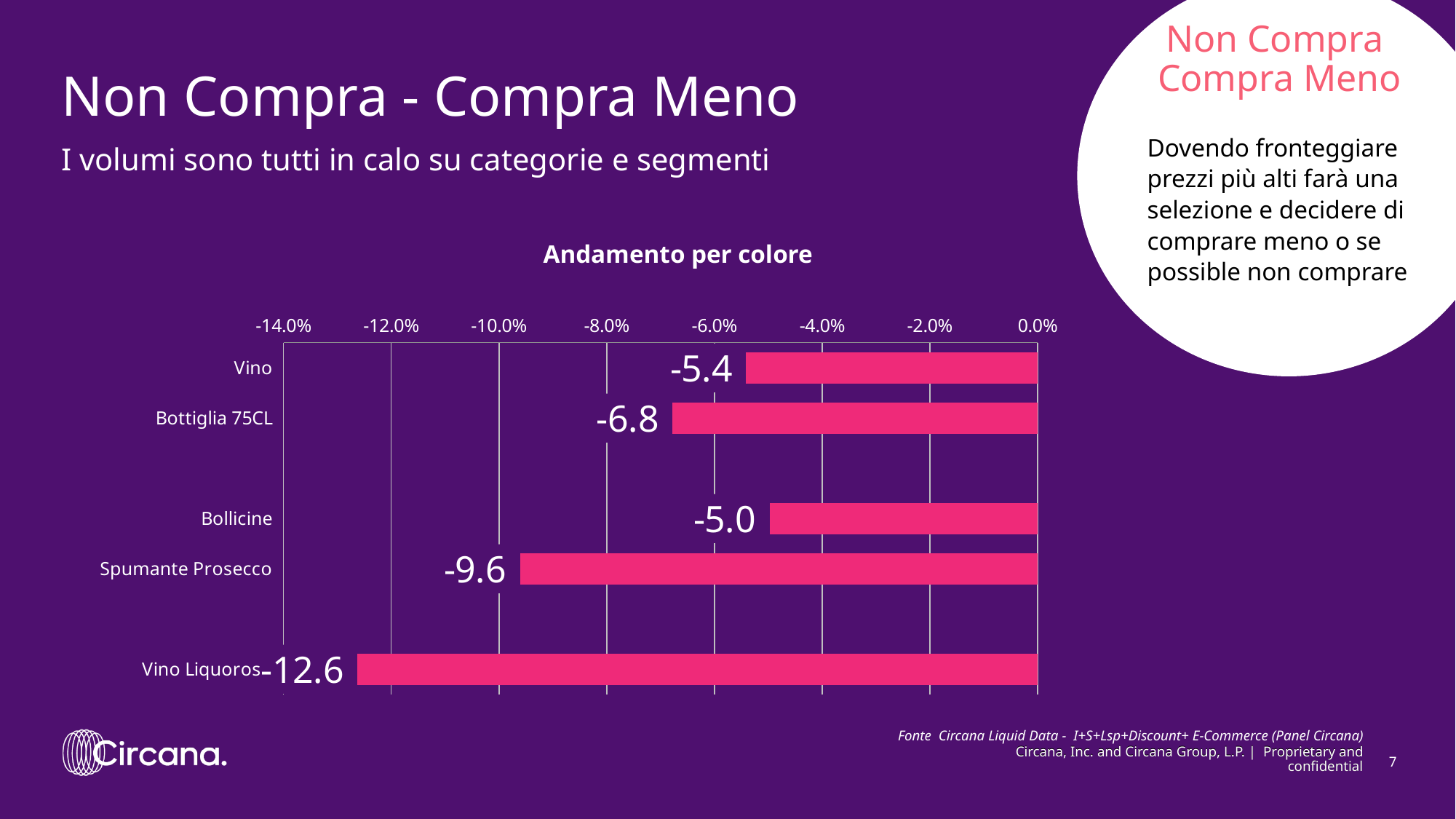
What is the value shown for Spumante Prosecco? -9.6 What kind of chart is shown on the slide? Bar chart Which category has the smallest decline (the highest value) in the chart? Bollicine Which has a larger decline, Spumante Prosecco or Bollicine? Spumante Prosecco What is the difference between the values for Vino and Bottiglia 75CL? 1.4 What is the difference between the values for Vino Liquoros and Spumante Prosecco? 3.0 What is the value shown for Vino in the Andamento per colore chart? -5.4 What is the value shown for Vino Liquoros? -12.6 What is the title of the chart? Andamento per colore Which category has the largest decline (the lowest value) in the chart? Vino Liquoros How many categories are shown in the chart? 5 What is the value shown for Bottiglia 75CL? -6.8